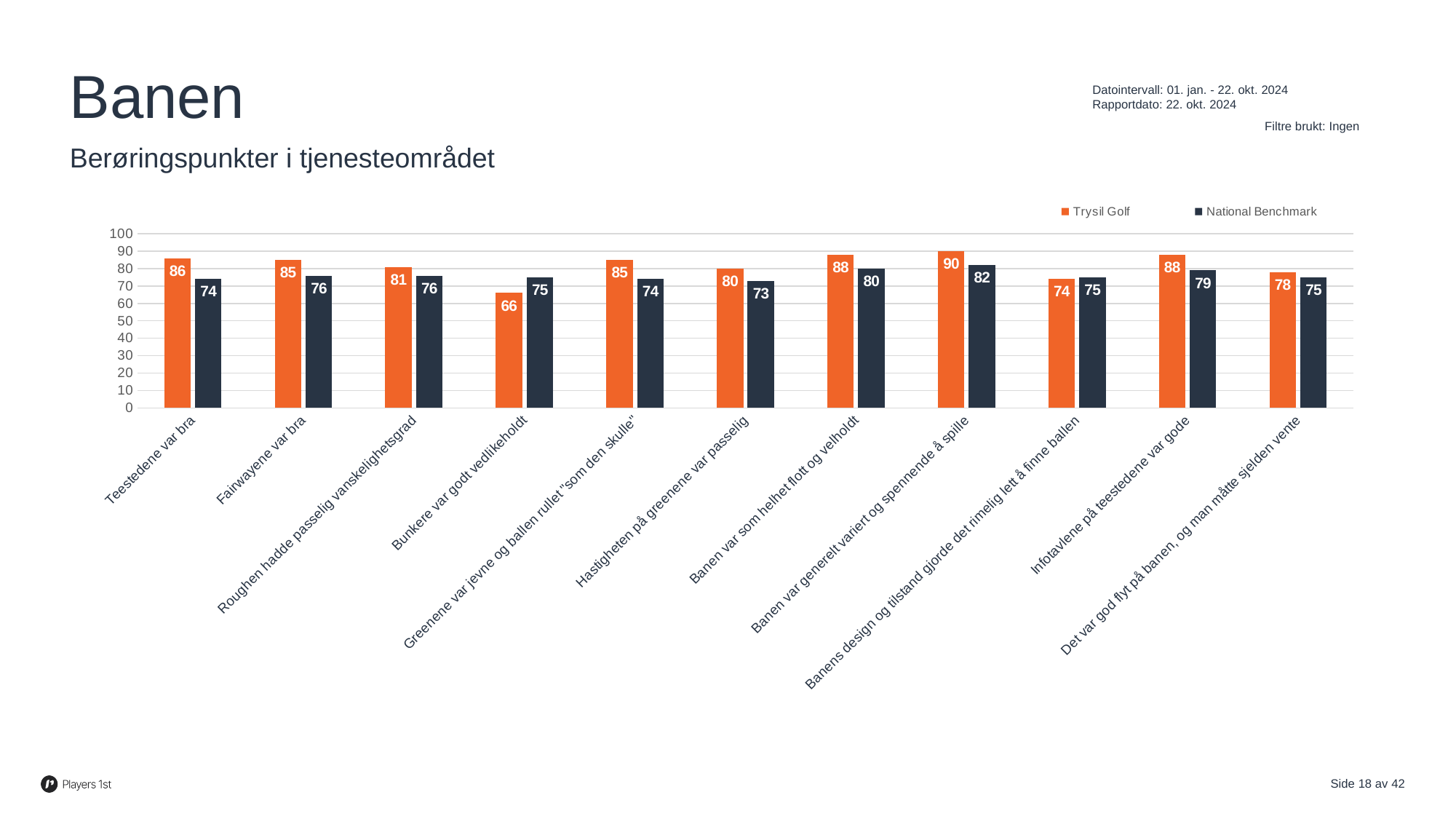
What kind of chart is shown on the slide? Bar chart Which category has the lowest Trysil Golf value? Bunkere var godt vedlikeholdt Which category has the highest Trysil Golf value? Banen var generelt variert og spennende å spille Which category has the lowest National Benchmark value? Hastigheten på greenene var passelig For "Bunkere var godt vedlikeholdt", which is larger: Trysil Golf or National Benchmark? National Benchmark What is the difference between the Trysil Golf and National Benchmark values for "Teestedene var bra"? 12 Which colour represents the Trysil Golf series in the chart? Orange What is the National Benchmark value for "Banen var generelt variert og spennende å spille"? 82 How many categories are shown on the x axis? 11 What is the Trysil Golf value for "Teestedene var bra"? 86 How many series does the legend list? 2 What is the National Benchmark value for "Bunkere var godt vedlikeholdt"? 75